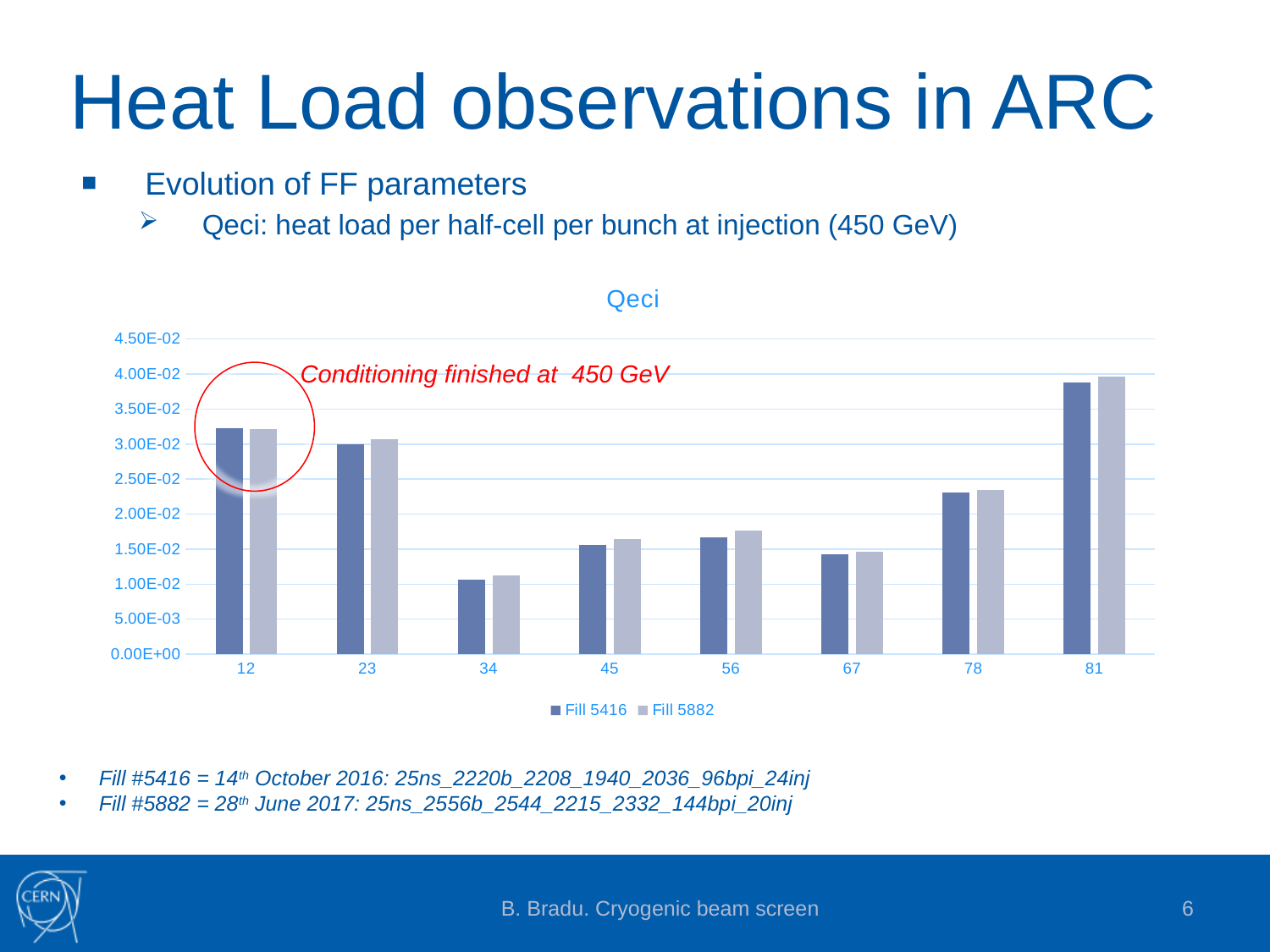
Which category has the lowest value for Fill 5416? 34 Is the value for category 34 in Fill 5882 greater or less than 1.50E-02? less What are the two series named in the legend? Fill 5416 and Fill 5882 What kind of chart is shown on the slide? bar chart For Fill 5416, which is larger: the value for category 56 or the value for category 34? 56 How many categories are shown on the x axis of the chart? 8 How many series does the chart legend list? 2 Is the value for category 81 in Fill 5416 greater or less than 3.50E-02? greater What is the title of the chart? Qeci For Fill 5882, which is larger: the value for category 23 or the value for category 67? 23 Is the value for category 78 in Fill 5416 greater or less than 2.00E-02? greater Which category has the highest value for Fill 5882? 81